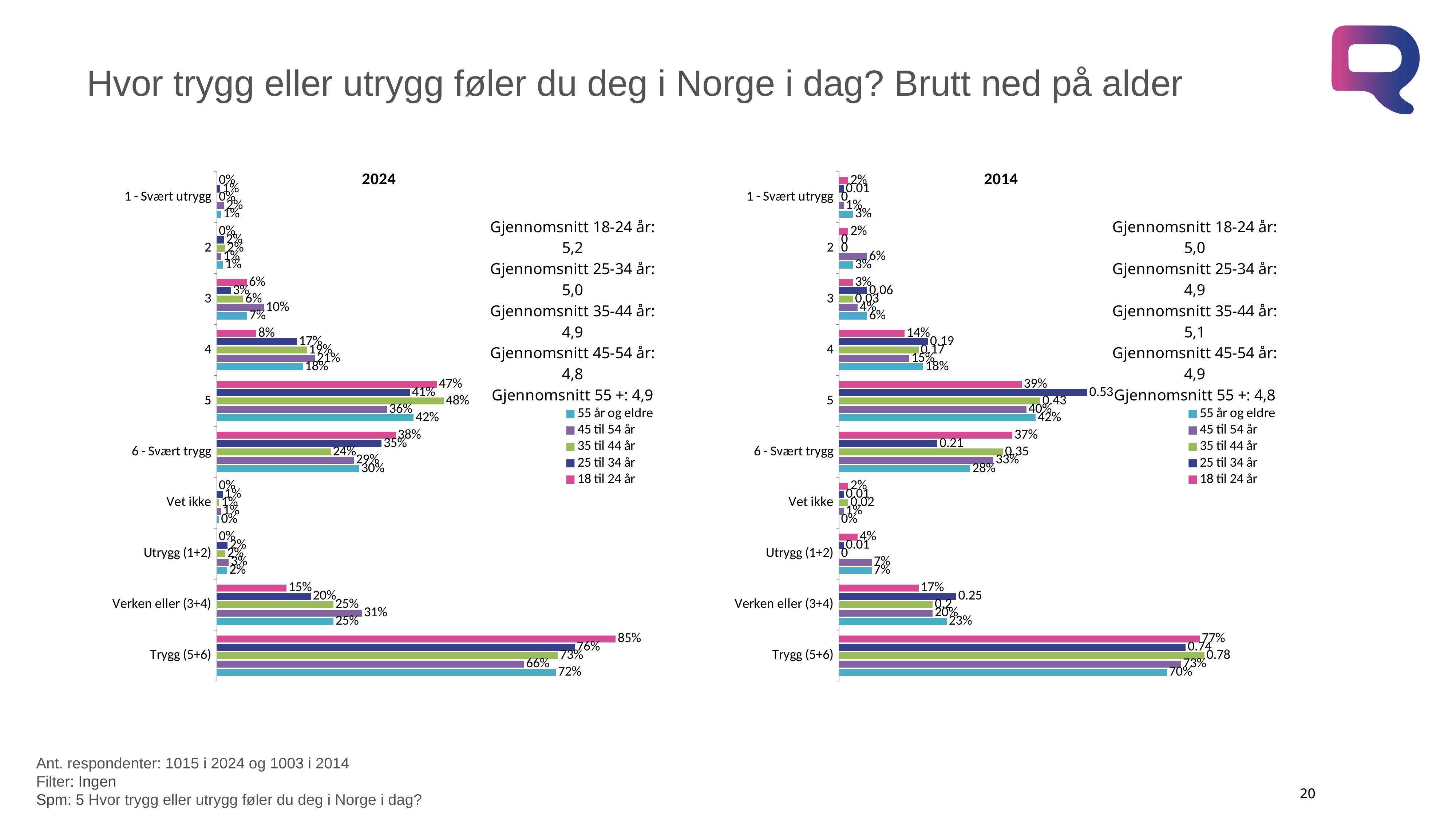
In the 2024 chart, what is the value for 35 til 44 år in category 5? 48% In the 2024 chart, in the Verken eller (3+4) category, which is larger: 45 til 54 år or 18 til 24 år? 45 til 54 år What is the title of the chart on the right side of the slide? 2014 In the 2014 chart, what is the value for 55 år og eldre in the Trygg (5+6) category? 70% In the 2024 chart, what is the difference between the Trygg (5+6) values for 18 til 24 år and 45 til 54 år? 19 percentage points In the 2024 chart, which age group has the highest value in the Trygg (5+6) category? 18 til 24 år What kind of chart is the 2024 chart? Bar chart How many series does the legend of the 2024 chart list? 5 In the 2024 chart, which age group has the lowest value in the Trygg (5+6) category? 45 til 54 år In the 2024 chart, what is the value for 18 til 24 år in the Trygg (5+6) category? 85% How many categories are shown on the y axis of the 2014 chart? 10 In the 2014 chart, what is the value for 18 til 24 år in the 6 - Svært trygg category? 37%